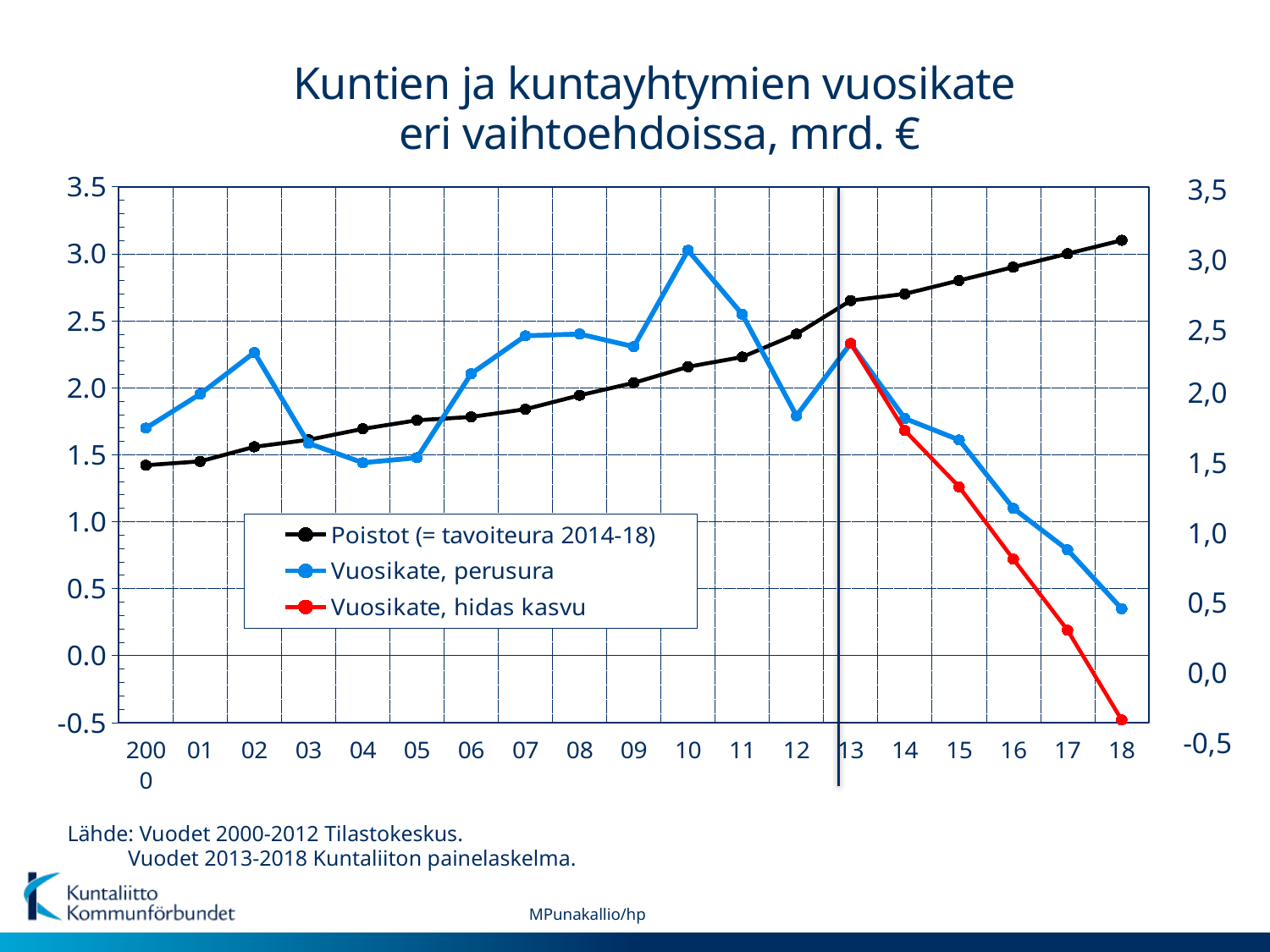
In which year does the 'Vuosikate, perusura' series reach its highest value? 2010 Does the 'Poistot (= tavoiteura 2014-18)' series generally rise or fall from 2000 to 2018? rise Is the value of 'Vuosikate, hidas kasvu' in 2018 greater or less than 0.0? less In 2002, which series has the larger value: 'Poistot (= tavoiteura 2014-18)' or 'Vuosikate, perusura'? Vuosikate, perusura Is the value of 'Vuosikate, perusura' in 2010 greater or less than 2.5? greater In which year does the 'Vuosikate, hidas kasvu' series reach its lowest value? 2018 Is the value of 'Poistot (= tavoiteura 2014-18)' in 2000 greater or less than 1.5? less How many series does the legend list? 3 Which colour is used for the 'Vuosikate, hidas kasvu' series? red How many years are shown on the x axis? 19 What kind of chart is shown on the slide? line chart